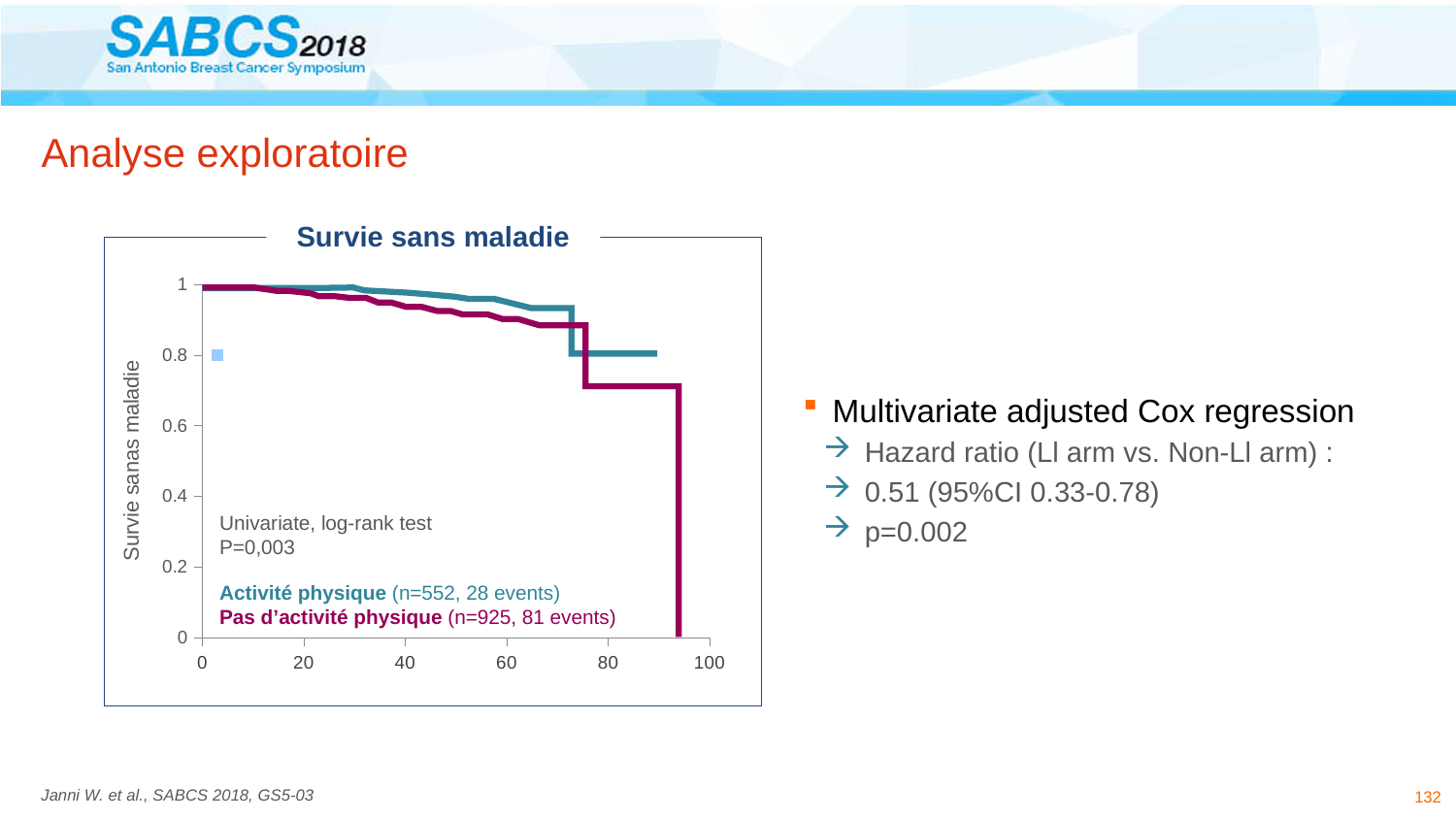
At x = 40, which curve is higher: Activité physique or Pas d'activité physique? Activité physique According to the chart legend, how many patients are in the Activité physique group? n=552 How many series (curves) are plotted in the chart? 2 Is the value of the Pas d'activité physique curve at x = 90 greater or less than 0.8? less Do the survival curves rise or fall as the x axis increases? fall Which curve drops to 0 on the y axis near the right end of the chart? Pas d'activité physique What is the title of the chart? Survie sans maladie Is the value of the Activité physique curve at x = 60 greater or less than 0.8? greater Is the value of the Pas d'activité physique curve at x = 90 greater or less than 0.6? greater At x = 80, which curve is higher: Activité physique or Pas d'activité physique? Activité physique What kind of chart is shown on the slide? line chart